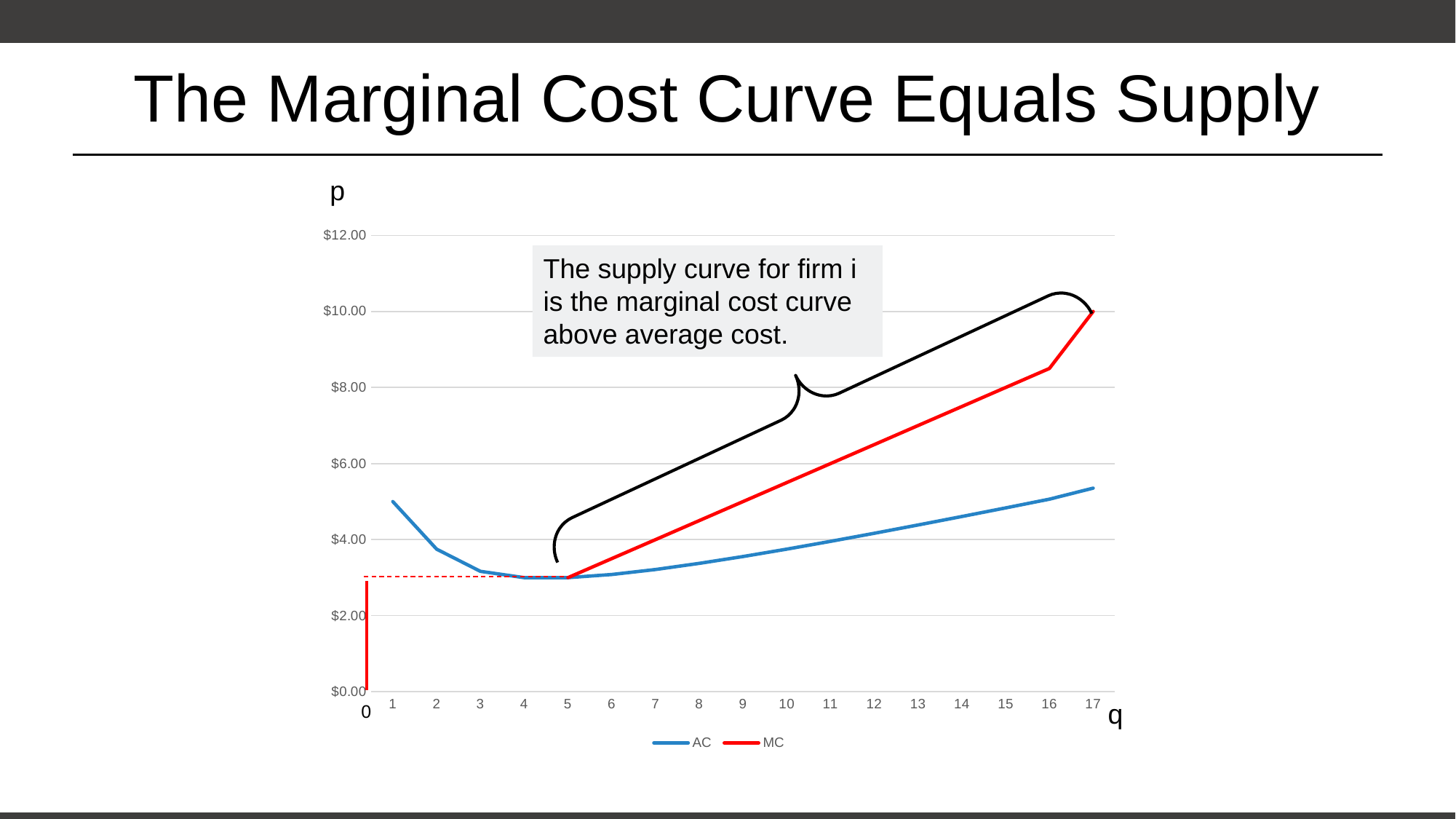
Is the value of AC at q = 17 greater or less than $6.00? less At q = 17, which is larger, AC or MC? MC What are the two series named in the legend? AC and MC Is the value of AC at q = 1 greater or less than $4.00? greater Does the MC line rise or fall as q increases from 5 to 17? rise Is the value of MC at q = 12 greater or less than $6.00? greater How many series does the legend list? 2 How many quantity values are labelled along the x axis? 17 What colour is the MC line? red What kind of chart is shown on the slide? line chart What is the value of MC at q = 17? $10.00